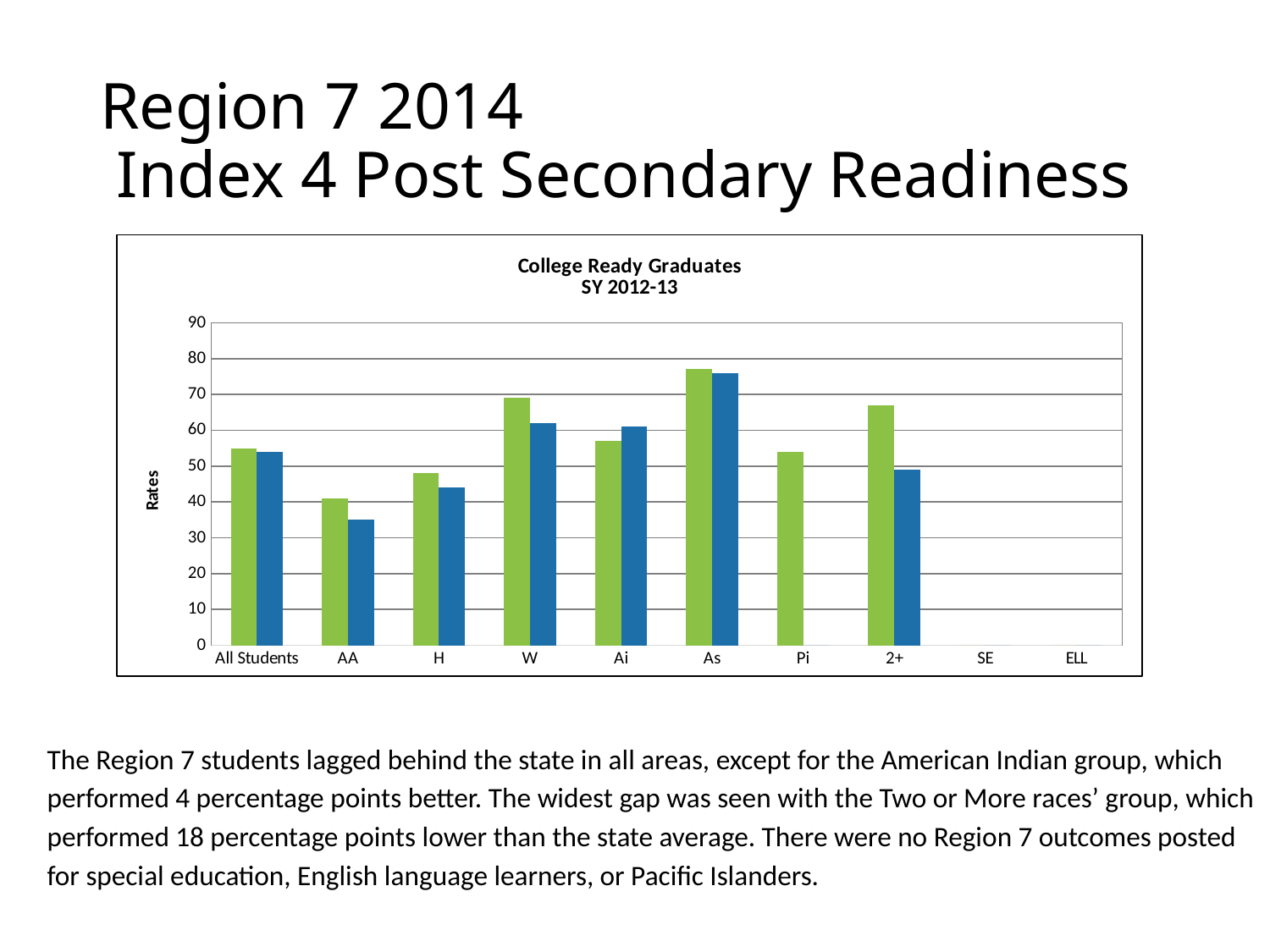
Among the categories with a green bar, which has the shortest green bar? AA For the Ai category, is the green bar or the blue bar taller? blue How many categories are shown along the x axis of the chart? 10 Which category has the tallest green bar? As Is the blue bar for AA greater or less than 40? less Among the categories with a blue bar, which has the shortest blue bar? AA What is the label on the vertical axis of the chart? Rates What is the title of the chart? College Ready Graduates SY 2012-13 What kind of chart is shown on the slide? bar chart Is the green bar for W greater or less than 60? greater For the W category, is the green bar or the blue bar taller? green Which category has the tallest blue bar? As